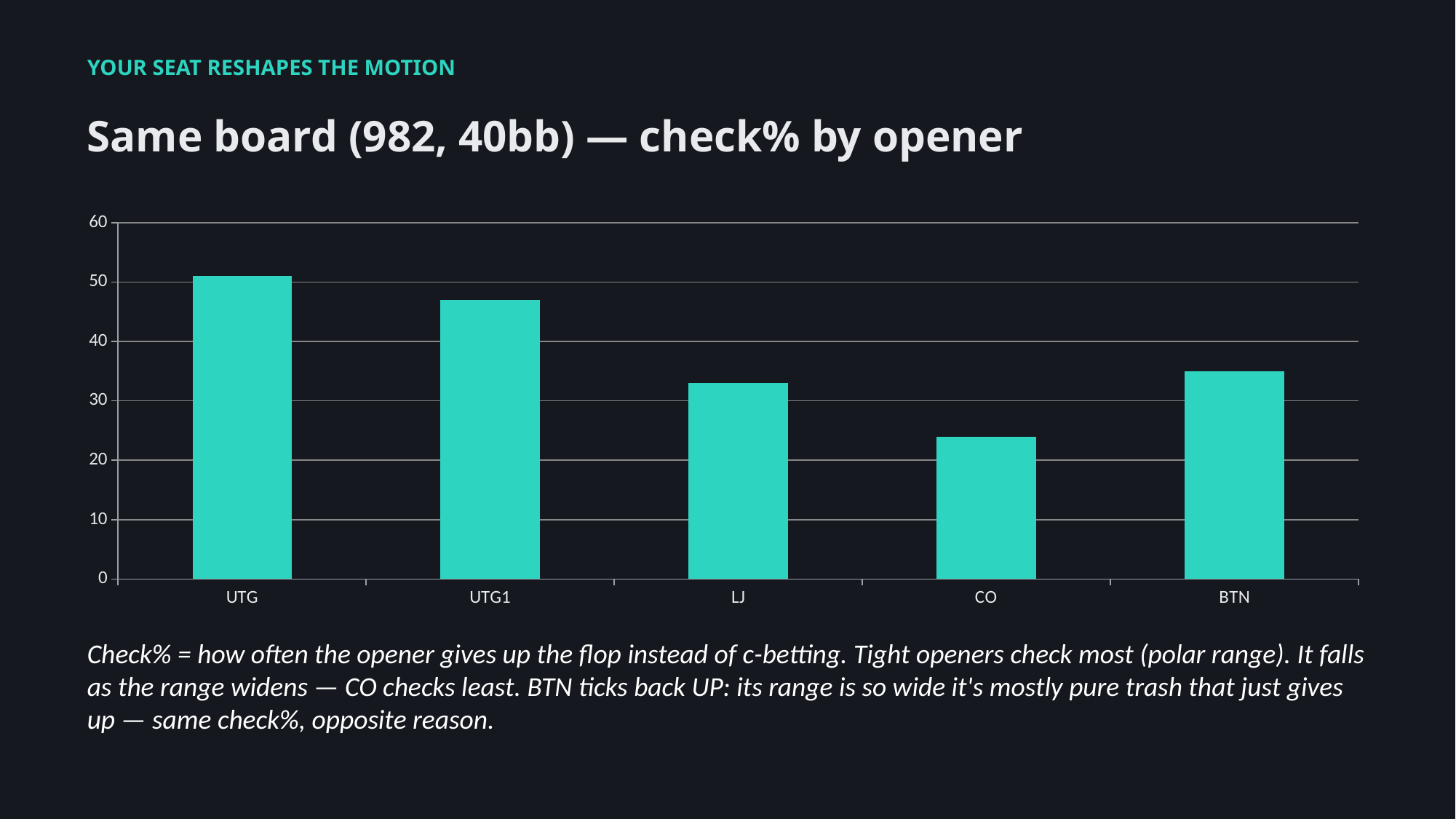
Do the values rise or fall from UTG to CO along the x axis? fall Is the value for UTG1 greater or less than 40? greater What kind of chart is shown on the slide? bar chart How many opener positions are shown on the x axis? 5 Is the value for BTN greater or less than 40? less Which has a higher check%, CO or BTN? BTN Which opener position has the lowest check%? CO Is the value for CO greater or less than 30? less Which opener position has the highest check%? UTG Which has a higher check%, UTG1 or LJ? UTG1